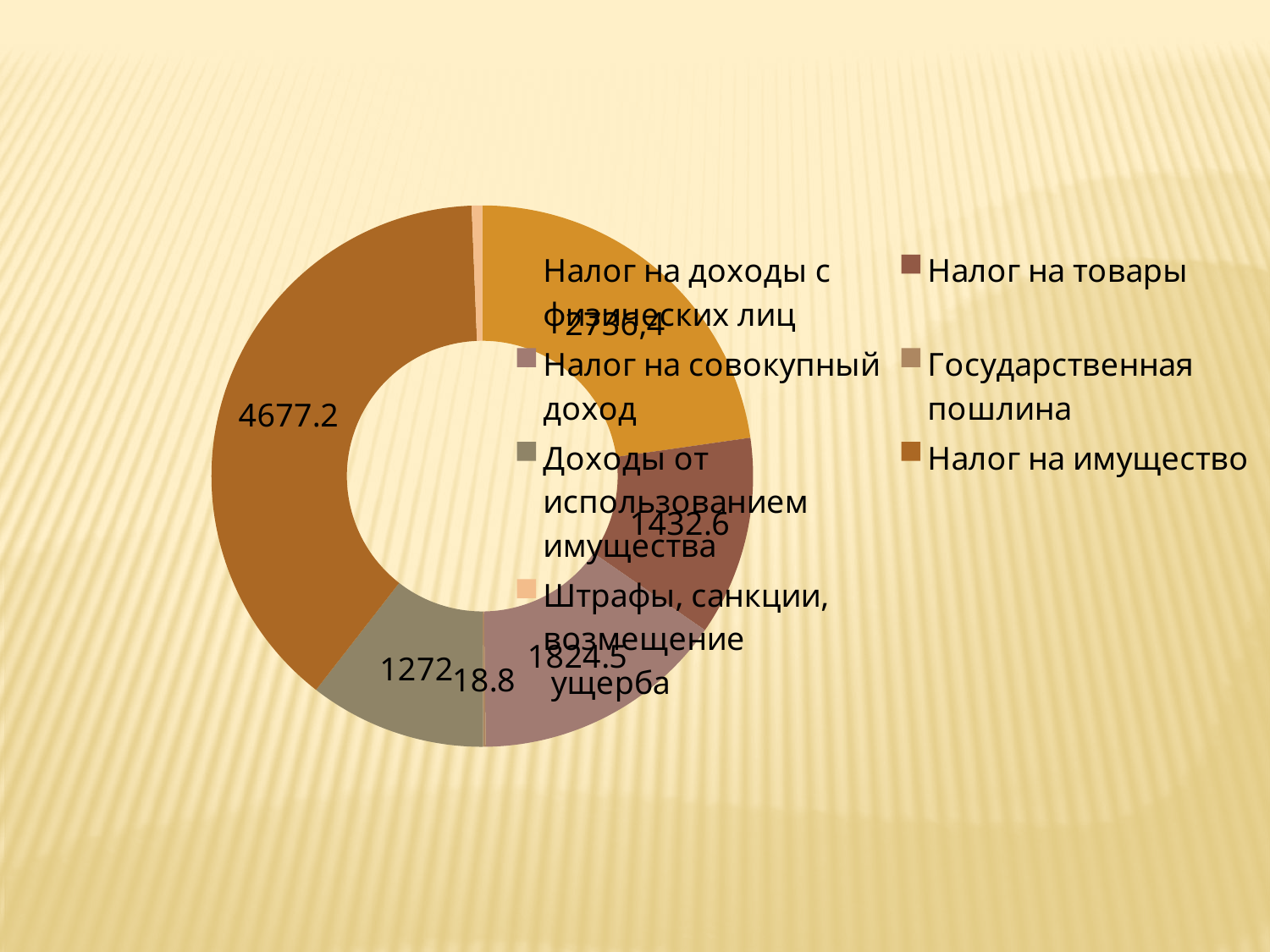
Which is larger, Доходы от использованием имущества or Налог на имущество? Налог на имущество What kind of chart is shown on the slide? Doughnut (pie) chart What is the value for Налог на совокупный доход? 1824.5 What is the difference between Налог на совокупный доход and Доходы от использованием имущества? 552.5 How many categories does the legend list? 7 What is the difference between Налог на имущество and Налог на товары? 3244.6 Which category has the largest slice? Налог на имущество What is the value for Доходы от использованием имущества? 1272 What is the value for Налог на товары? 1432.6 What is the value for Налог на имущество? 4677.2 Which is larger, Налог на товары or Налог на совокупный доход? Налог на совокупный доход Which legend entry is listed last in the right-hand column of the legend? Налог на имущество